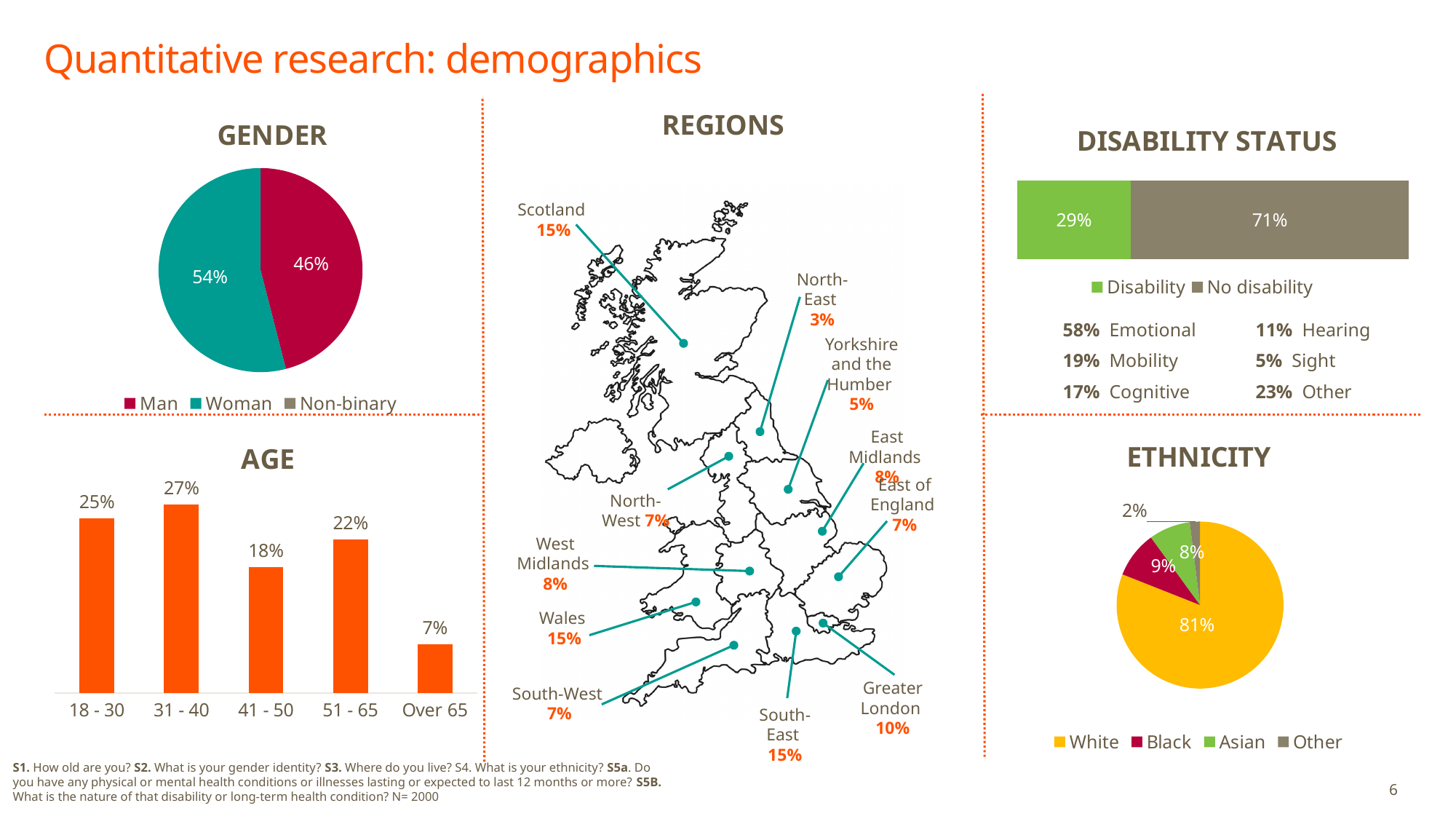
On the AGE chart, which age group has the lowest value? Over 65 On the AGE chart, which is larger, the value for 51 - 65 or the value for 41 - 50? 51 - 65 On the AGE chart, which age group has the highest value? 31 - 40 On the GENDER pie chart, what share is labelled for Woman? 54% On the ETHNICITY pie chart, what share is labelled for White? 81% On the ETHNICITY pie chart, which is larger, the share for Black or the share for Asian? Black What kind of chart is the AGE chart? bar chart On the AGE chart, what is the value for the 41 - 50 age group? 18% On the AGE chart, how many age groups are shown? 5 How many entries does the legend of the GENDER chart list? 3 On the DISABILITY STATUS chart, what is the value for No disability? 71% On the AGE chart, what is the difference between the values for 18 - 30 and Over 65? 18%